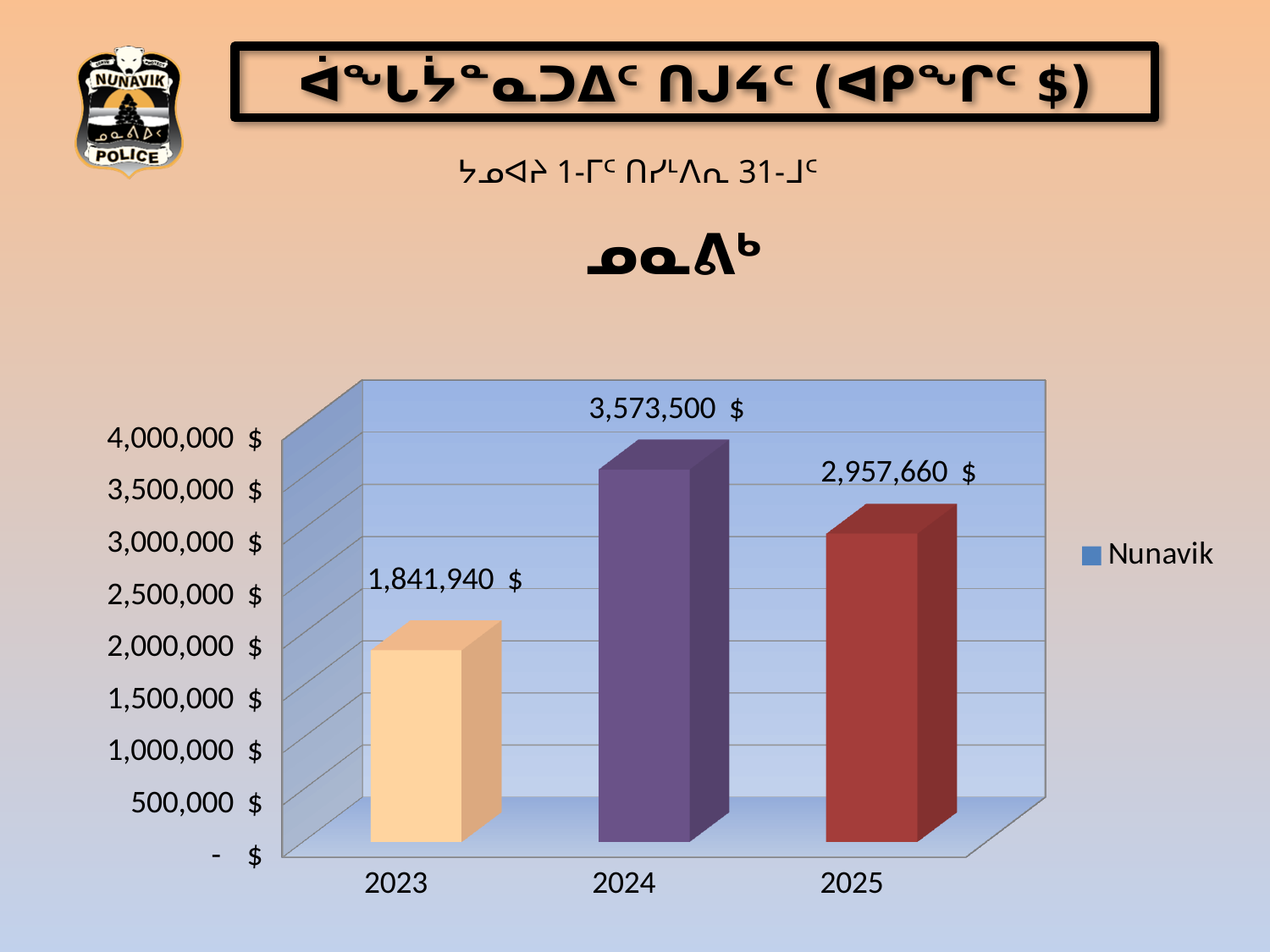
Which is larger, the value for 2025 or the value for 2023? 2025 Which year has the highest value? 2024 Which year has the lowest value? 2023 How many series does the legend list? 1 What is the difference between the values for 2024 and 2025? 615,840 $ What is the value for 2023? 1,841,940 $ How many years are shown on the x axis? 3 Is the value for 2025 greater or less than 3,000,000 $? less What is the value for 2024? 3,573,500 $ What is the difference between the values for 2024 and 2023? 1,731,560 $ What kind of chart is shown on the slide? bar chart What is the value for 2025? 2,957,660 $